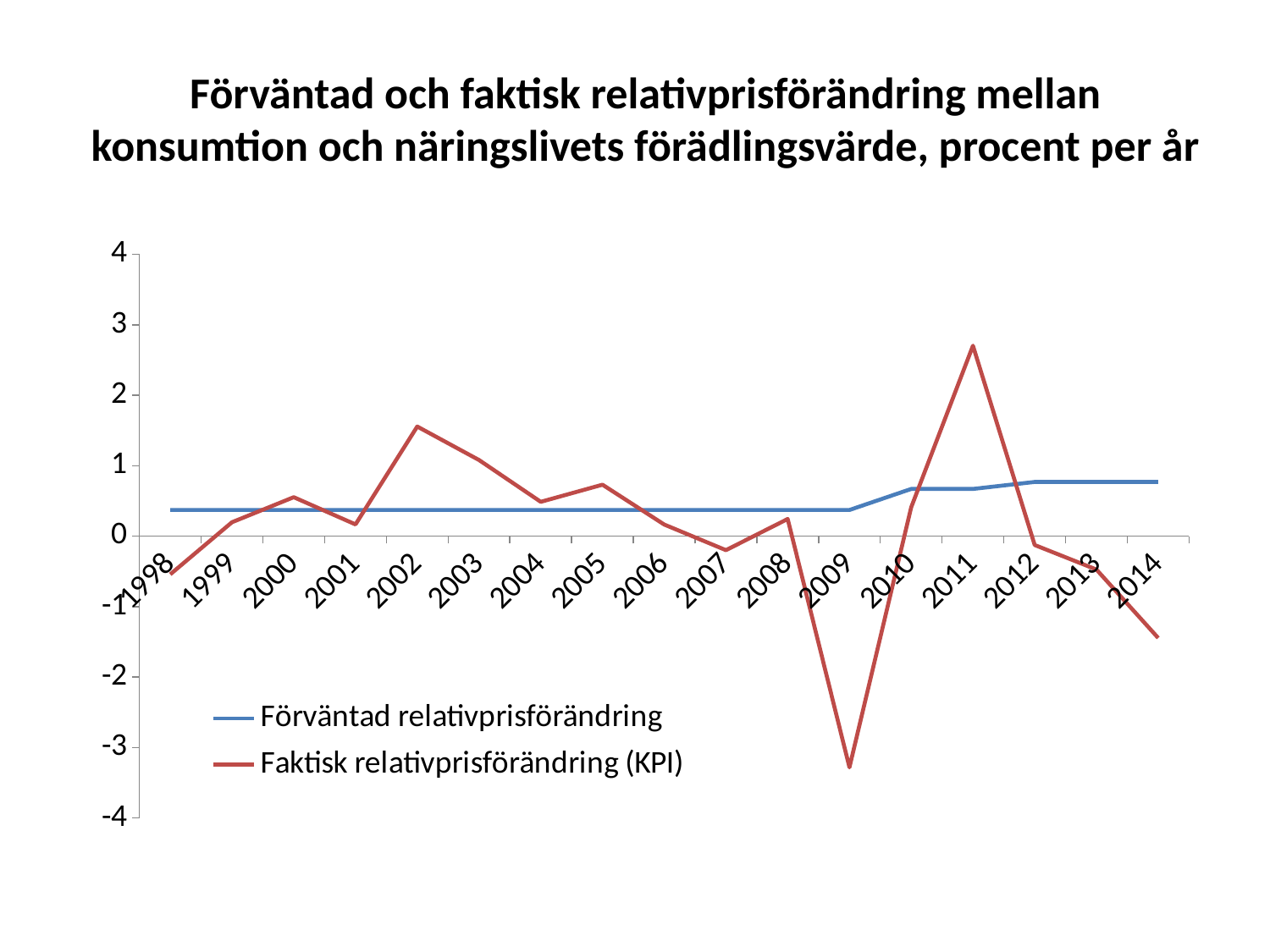
Is the value for Faktisk relativprisförändring (KPI) in 2011 greater or less than 2? greater In which year does the Faktisk relativprisförändring (KPI) series reach its lowest value? 2009 How many years are shown on the x axis? 17 Does the Förväntad relativprisförändring series rise or fall between 2009 and 2012? rise In 2009, which series has the higher value, Förväntad relativprisförändring or Faktisk relativprisförändring (KPI)? Förväntad relativprisförändring Is the value for Faktisk relativprisförändring (KPI) in 2002 greater or less than 1? greater In which year does the Faktisk relativprisförändring (KPI) series reach its highest value? 2011 What kind of chart is shown on the slide? line chart Is the value for Faktisk relativprisförändring (KPI) in 2009 greater or less than -3? less How many series does the legend list? 2 For Faktisk relativprisförändring (KPI), which year has the larger value, 2002 or 2011? 2011